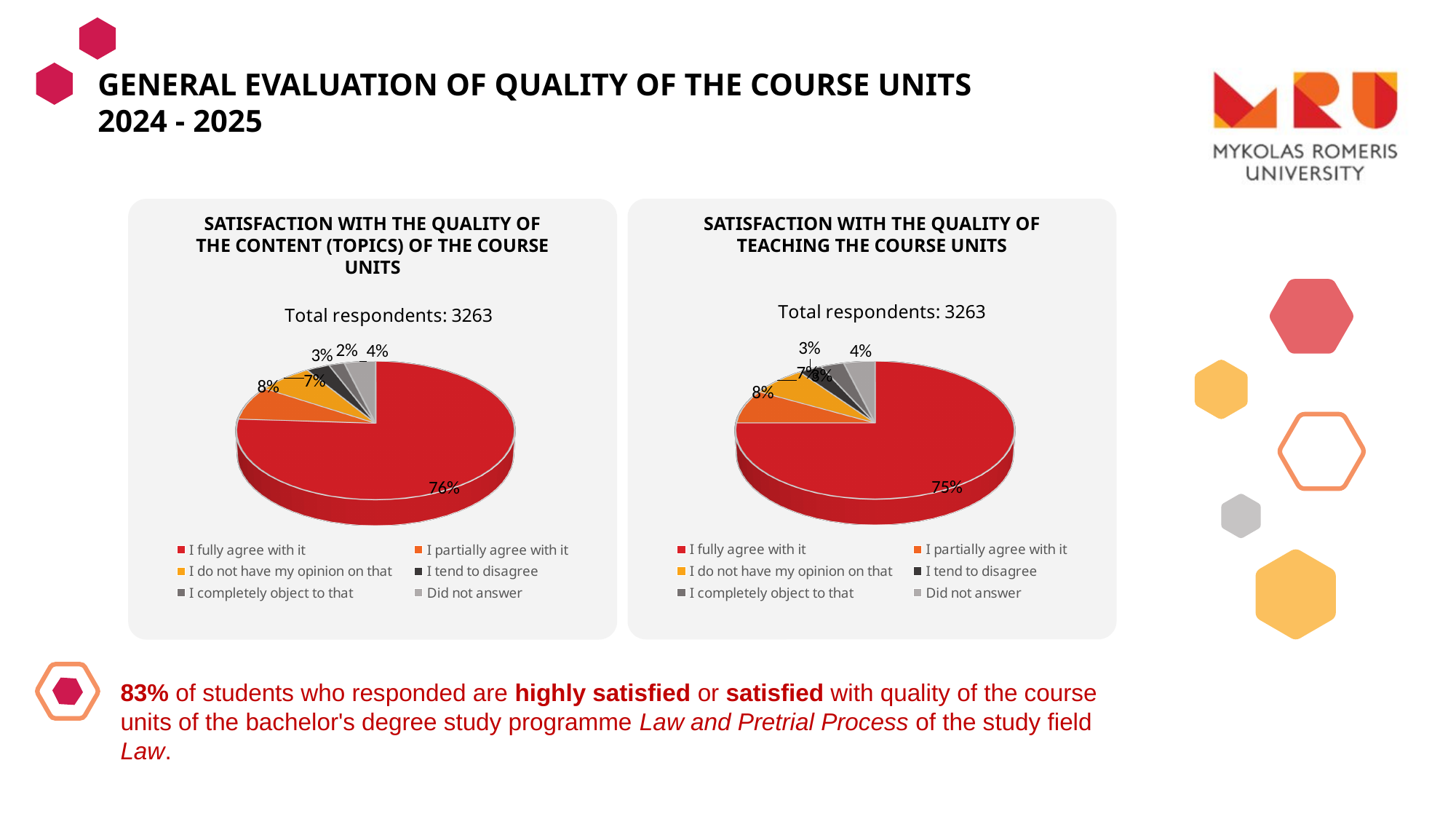
In the right chart (teaching the course units), what percentage 'Did not answer'? 4% In the left chart (content of the course units), what is the difference between the 'I fully agree with it' share and the 'I partially agree with it' share? 68% In the left chart (content of the course units), which response category has the largest slice? I fully agree with it In the left chart (content of the course units), what percentage chose 'I completely object to that'? 2% Which chart has a larger 'I fully agree with it' share: the content chart or the teaching chart? The content chart In the chart titled 'Satisfaction with the quality of teaching the course units', what share of respondents chose 'I fully agree with it'? 75% In the chart titled 'Satisfaction with the quality of the content (topics) of the course units', what share of respondents chose 'I fully agree with it'? 76% In the left chart (content of the course units), which response category has the smallest slice? I completely object to that In the left chart (content of the course units), what percentage chose 'I partially agree with it'? 8% What type of chart is used in the 'Satisfaction with the quality of teaching the course units' panel? Pie chart In the left chart (content of the course units), what percentage 'Did not answer'? 4% How many response categories does the legend of the left chart (content of the course units) list? 6